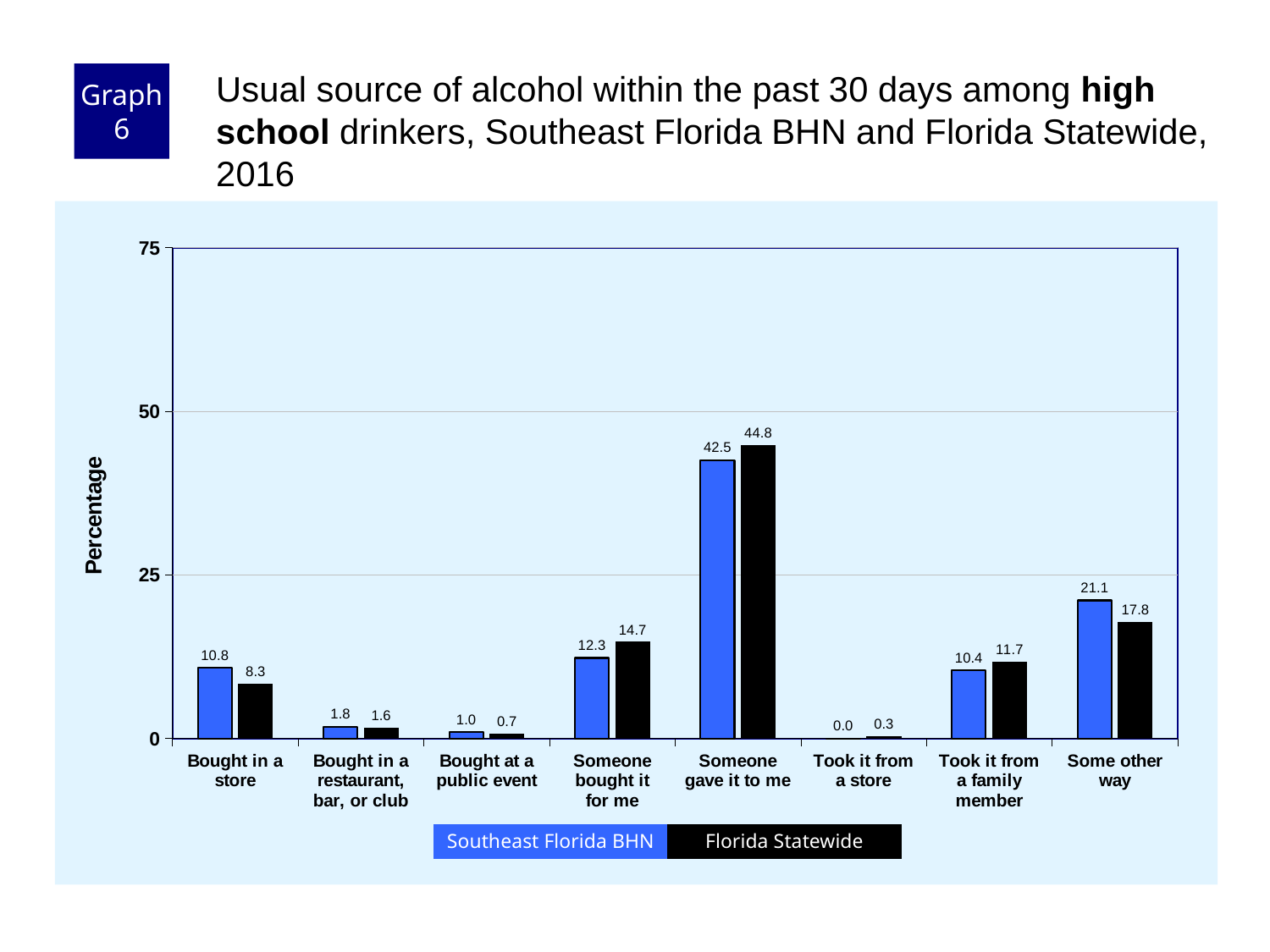
What is the difference between the Florida Statewide and Southeast Florida BHN values for "Someone gave it to me"? 2.3 What is the label of the y axis? Percentage What kind of chart is shown on the slide? bar chart Which category has the lowest Southeast Florida BHN value? Took it from a store How many categories are shown on the x axis? 8 For "Some other way", which is larger: Southeast Florida BHN or Florida Statewide? Southeast Florida BHN How many series does the legend list? 2 Is the Southeast Florida BHN value for "Someone gave it to me" greater or less than 50? less What is the Florida Statewide value for "Took it from a store"? 0.3 Which category has the highest Florida Statewide value? Someone gave it to me What is the Florida Statewide value for "Bought in a store"? 8.3 What is the Southeast Florida BHN value for "Someone gave it to me"? 42.5